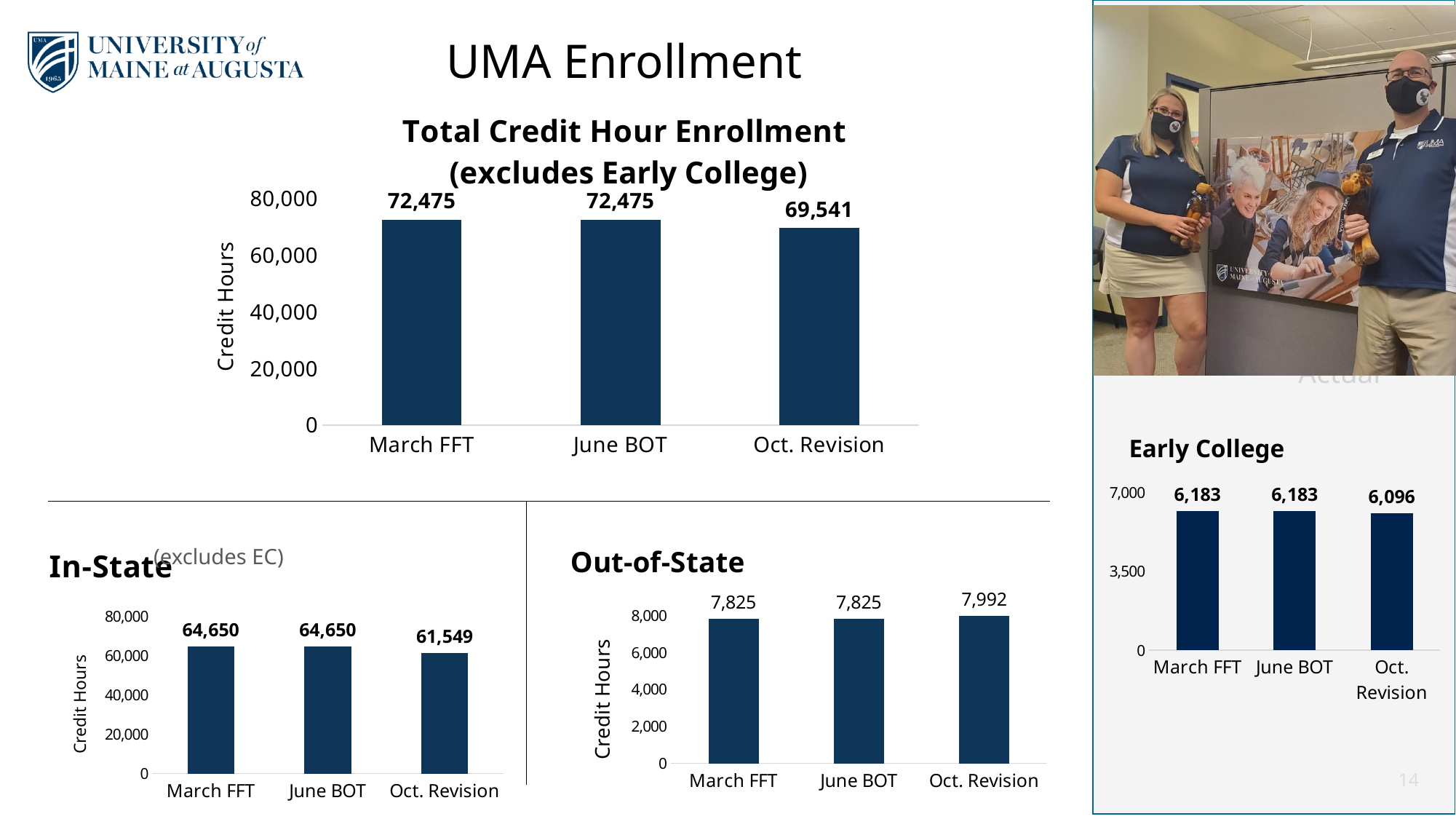
In the Out-of-State chart, what is the difference between the Oct. Revision and June BOT values? 167 In the Total Credit Hour Enrollment chart, what is the value for March FFT? 72,475 In the In-State chart, which category has the lowest value? Oct. Revision In the In-State chart, what is the value for Oct. Revision? 61,549 How many categories are shown in the Early College chart? 3 In the Out-of-State chart, which is larger, the value for March FFT or the value for Oct. Revision? Oct. Revision In the Early College chart, what is the value for June BOT? 6,183 In the Total Credit Hour Enrollment chart, what is the difference between the June BOT and Oct. Revision values? 2,934 In the Early College chart, what is the difference between the March FFT and Oct. Revision values? 87 In the Total Credit Hour Enrollment chart, what is the value for Oct. Revision? 69,541 In the Out-of-State chart, what is the value for Oct. Revision? 7,992 What kind of chart is the Total Credit Hour Enrollment chart? Bar chart